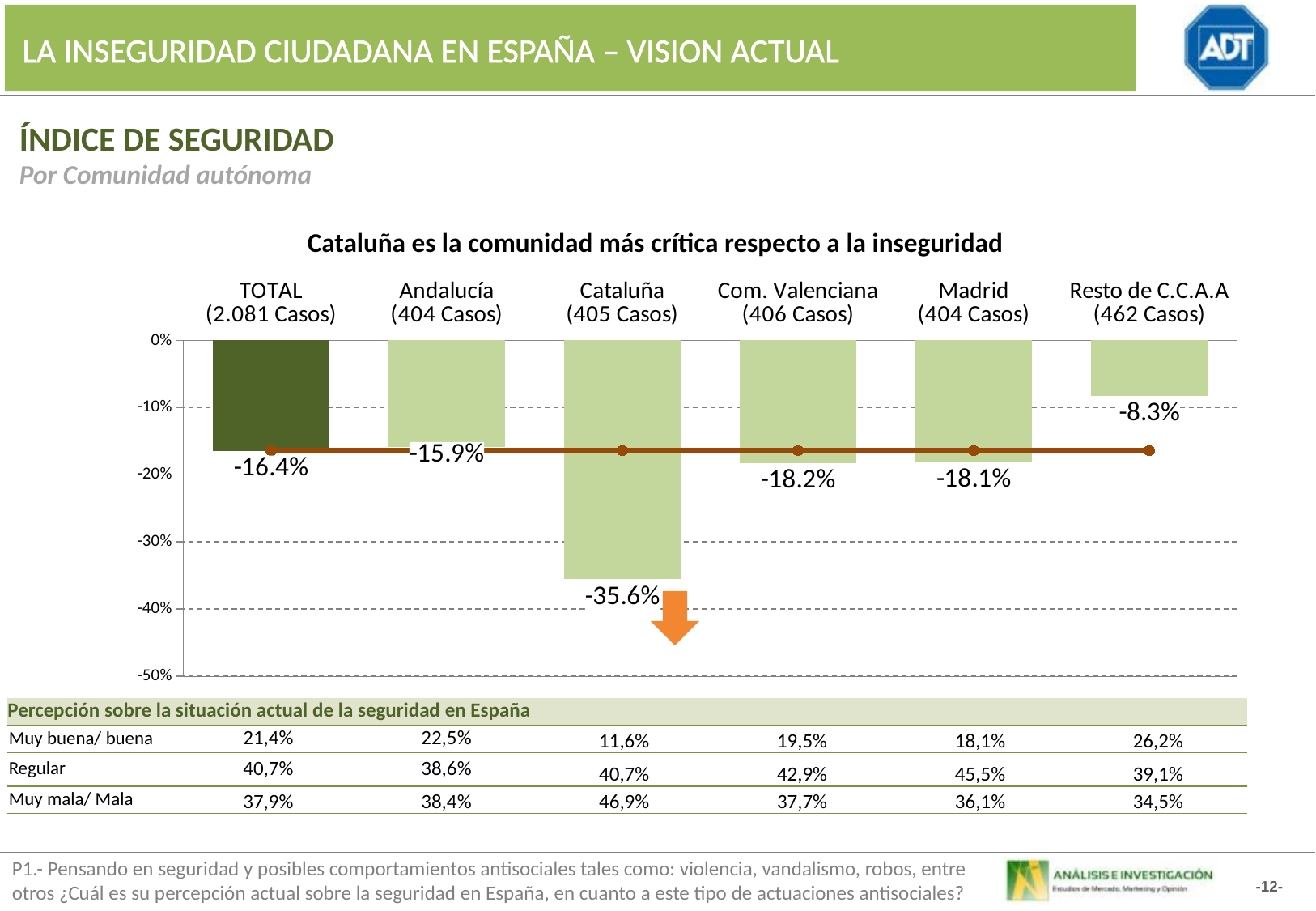
What type of chart is used to show the índice de seguridad by community? Bar chart What is the difference between the Andalucía value (-15.9%) and the Com. Valenciana value (-18.2%)? 2.3 percentage points What is the difference between the TOTAL value (-16.4%) and the Cataluña value (-35.6%)? 19.2 percentage points How many categories (bars) are shown in the chart? 6 What is the value shown for Madrid (404 Casos)? -18.1% What is the value shown for Resto de C.C.A.A (462 Casos)? -8.3% What is the value shown for Cataluña (405 Casos) in the chart? -35.6% What is the value shown for TOTAL (2.081 Casos) in the chart? -16.4% Which has a more negative value, Cataluña or Andalucía? Cataluña Which category has the highest (least negative) value in the chart? Resto de C.C.A.A Which community has the lowest (most negative) value in the chart? Cataluña Is the value for Cataluña greater or less than -30%? less